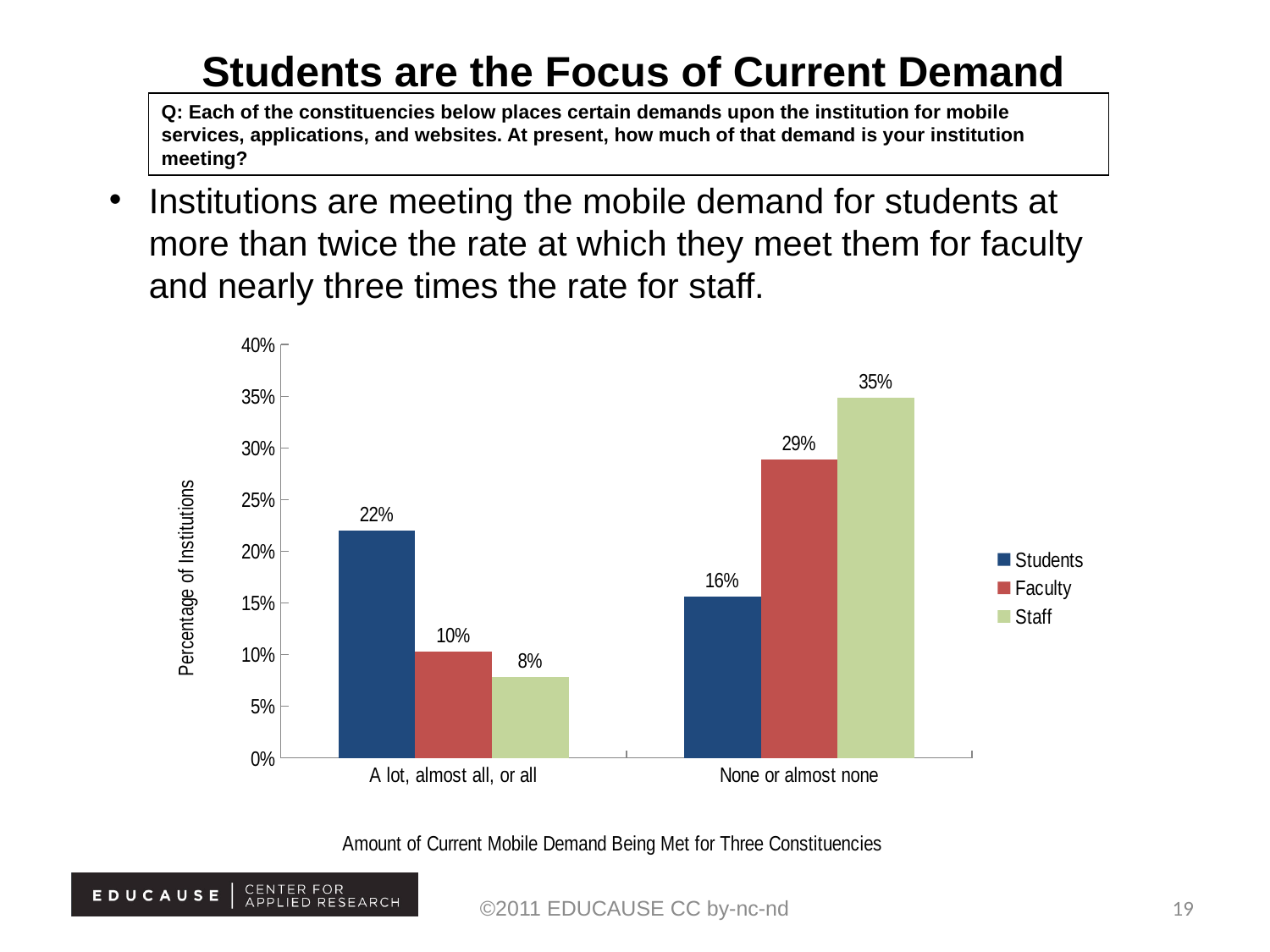
How many series does the legend list? 3 What is the label on the y axis of the chart? Percentage of Institutions What is the value for Staff in the 'None or almost none' category? 35% Which series has the highest value in the 'None or almost none' category? Staff How many categories are shown on the x axis? 2 What percentage of institutions report meeting 'A lot, almost all, or all' of the mobile demand for Students? 22% Which is larger: the Faculty value for 'None or almost none' or the Students value for 'A lot, almost all, or all'? Faculty value for 'None or almost none' Which series has the lowest value in the 'A lot, almost all, or all' category? Staff What is the value for Faculty in the 'A lot, almost all, or all' category? 10% What is the difference between the Staff and Students values in the 'None or almost none' category? 19% What is the difference between the Students and Staff values in the 'A lot, almost all, or all' category? 14% What kind of chart is shown on the slide? Bar chart